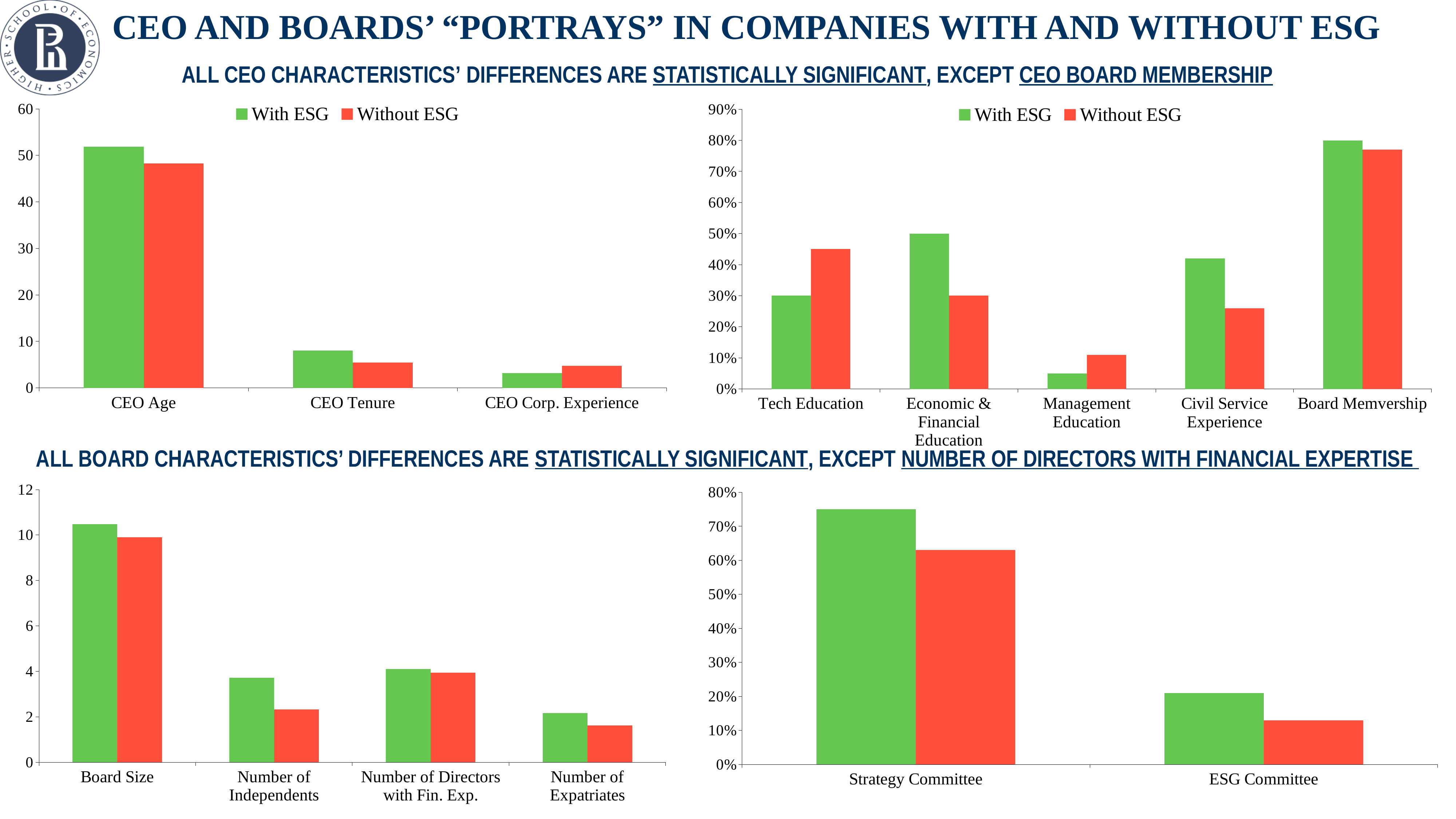
In the top-right chart, which category has the highest With ESG value? Board Memvership In the top-left chart, is the With ESG value for CEO Age greater or less than 50? greater What type of chart is the bottom-right chart? Bar chart In the top-right chart, which category has the lowest With ESG value? Management Education In the bottom-right chart, is the With ESG value for Strategy Committee greater or less than 70%? greater In the top-right chart, is the Without ESG value for Tech Education greater or less than 40%? greater In the top-right chart, how many series does the legend list? 2 In the bottom-left chart, which category has the highest With ESG value? Board Size In the top-left chart, which series has the larger value for CEO Corp. Experience, With ESG or Without ESG? Without ESG In the top-left chart, how many categories are shown on the x axis? 3 In the top-right chart, which series has the larger value for Economic & Financial Education, With ESG or Without ESG? With ESG